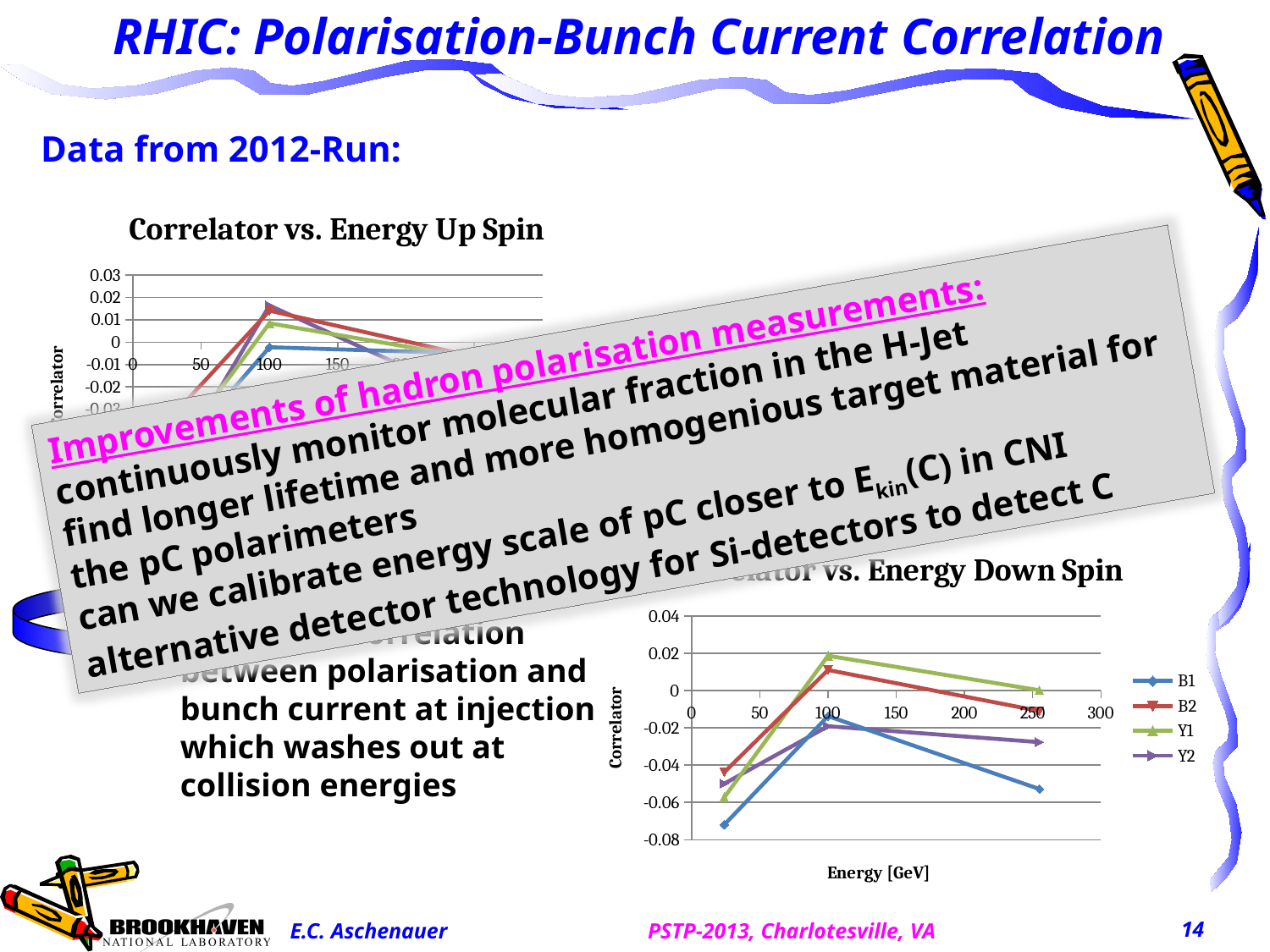
In the "Correlator vs. Energy Down Spin" chart, which is larger at 100 GeV: Y1 or B2? Y1 What kind of chart is the "Correlator vs. Energy Down Spin" chart? line chart In the "Correlator vs. Energy Down Spin" chart, does the B1 series rise or fall between 100 GeV and 250 GeV? fall In the "Correlator vs. Energy Down Spin" chart, is the value for B1 at the lowest energy point greater or less than -0.06? less In the "Correlator vs. Energy Down Spin" chart, how many data points does the B1 series have? 3 In the "Correlator vs. Energy Down Spin" chart, which series has the highest value at the highest energy point (around 250 GeV)? Y1 What are the legend entries of the "Correlator vs. Energy Down Spin" chart? B1, B2, Y1, Y2 In the "Correlator vs. Energy Down Spin" chart, which series has the lowest value at the highest energy point (around 250 GeV)? B1 In the "Correlator vs. Energy Down Spin" chart, which series has the lowest value at the lowest energy point (around 25 GeV)? B1 What is the x-axis title of the "Correlator vs. Energy Down Spin" chart? Energy [GeV] In the "Correlator vs. Energy Down Spin" chart, is the value for Y1 at 100 GeV greater or less than 0? greater How many series does the legend of the "Correlator vs. Energy Down Spin" chart list? 4